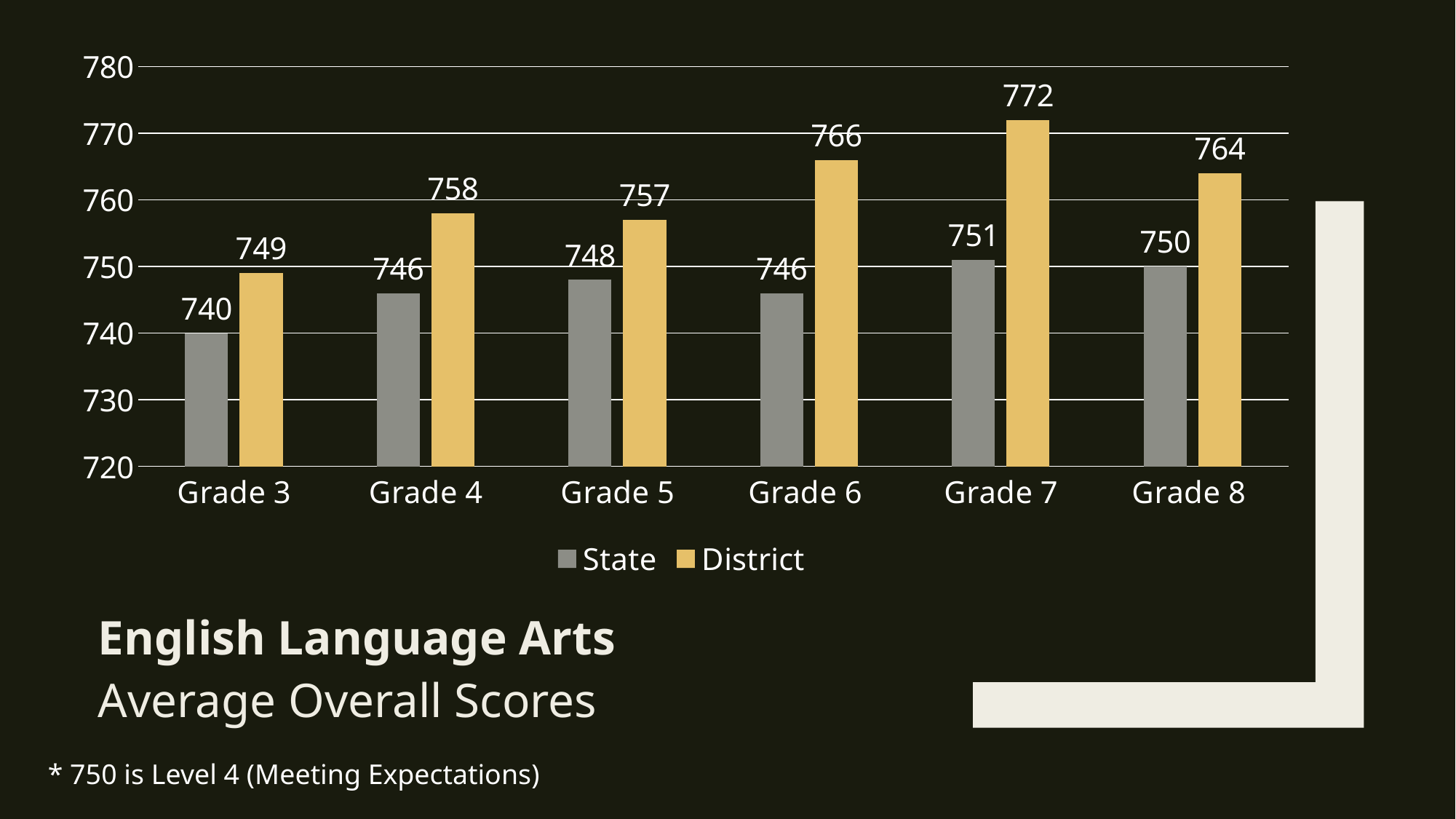
What kind of chart is shown on the slide? Bar chart Which grade has the highest District score? Grade 7 What is the State average overall score for Grade 3? 740 What is the District average overall score for Grade 7? 772 What is the difference between the District and State scores for Grade 6? 20 How many grades are shown on the x axis? 6 What is the difference between the District scores for Grade 7 and Grade 8? 8 How many series does the legend list? 2 Is the District score for Grade 4 greater or less than 750? greater Which grade has the lowest State score? Grade 3 What is the District score for Grade 5? 757 Which is larger, the State score for Grade 7 or the State score for Grade 8? Grade 7